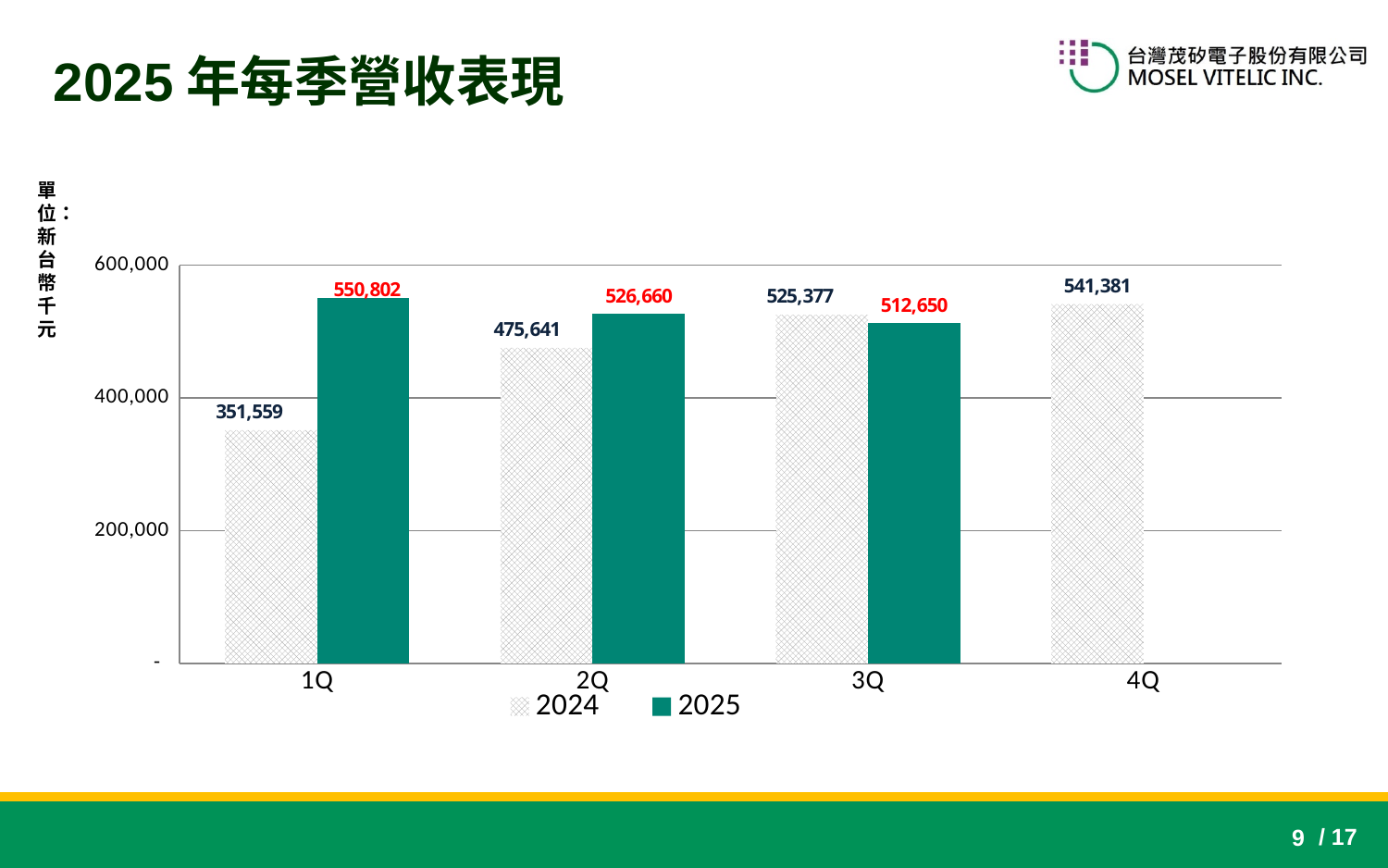
Which quarter has the lowest 2024 revenue? 1Q How many quarters are shown on the x axis? 4 What is the 2024 revenue for 4Q? 541,381 What is the 2025 revenue for 2Q? 526,660 In 3Q, which is larger, the 2024 revenue or the 2025 revenue? 2024 What is the difference between the 2025 and 2024 revenue in 2Q? 51,019 How many series does the legend list? 2 What is the 2025 revenue for 3Q? 512,650 Do the 2025 revenue values rise or fall from 1Q to 3Q? fall Which quarter has the highest 2025 revenue? 1Q What is the 2024 revenue for 1Q? 351,559 What is the difference between the 2025 and 2024 revenue in 1Q? 199,243